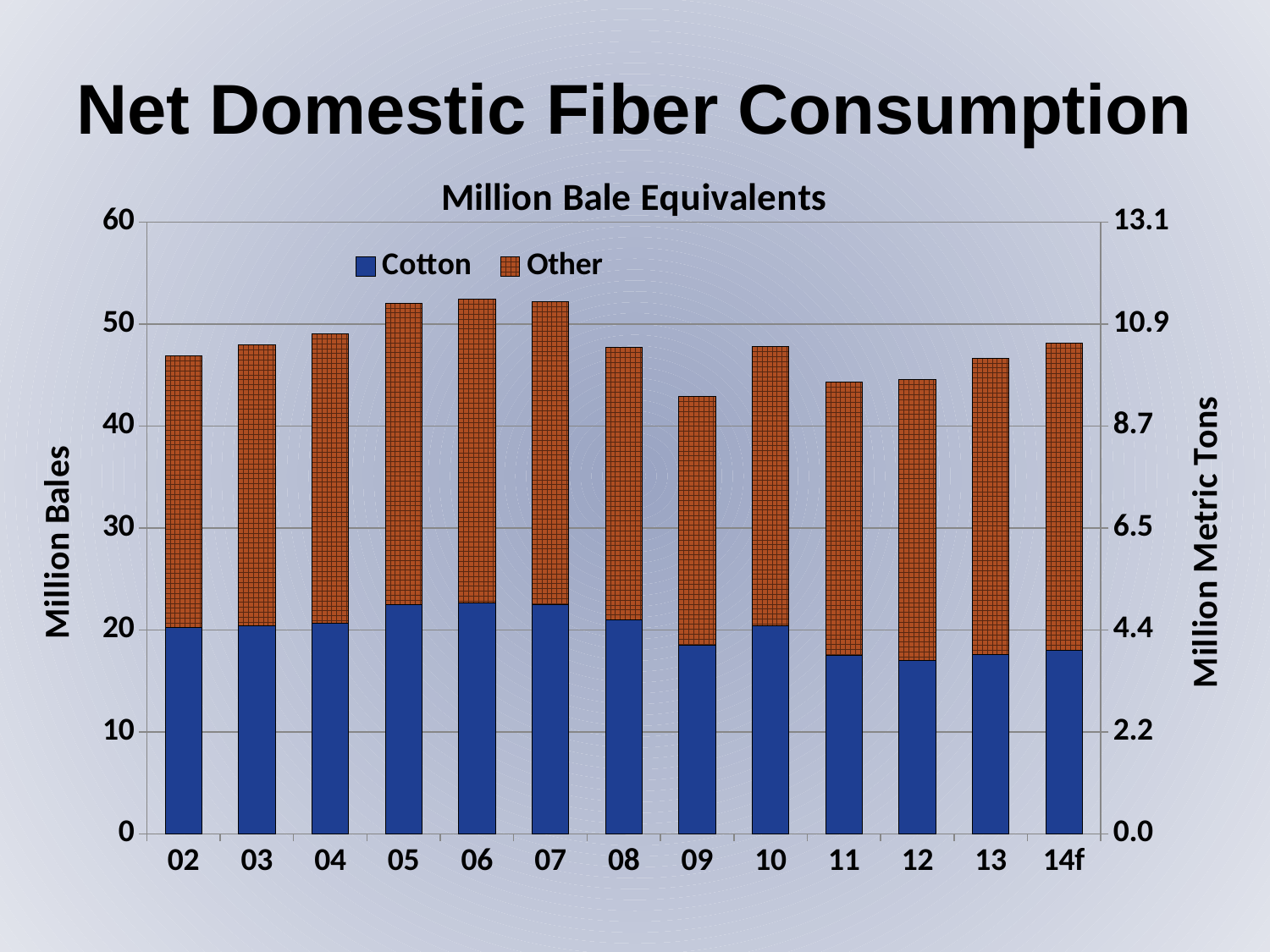
How many years (categories) are shown on the x axis? 13 What kind of chart is shown on the slide? Stacked bar chart Is the Cotton value for 12 greater or less than 20 million bales? less What is the label on the right-hand vertical axis? Million Metric Tons Which year has the larger total bar, 05 or 09? 05 How many series does the legend list? 2 Which year has the lowest total fiber consumption? 09 Is the total bar for 09 greater or less than 50 million bales? less Which year has the larger Cotton value, 06 or 12? 06 Do the total bars rise or fall from 02 to 06? rise Is the total bar for 06 greater or less than 50 million bales? greater